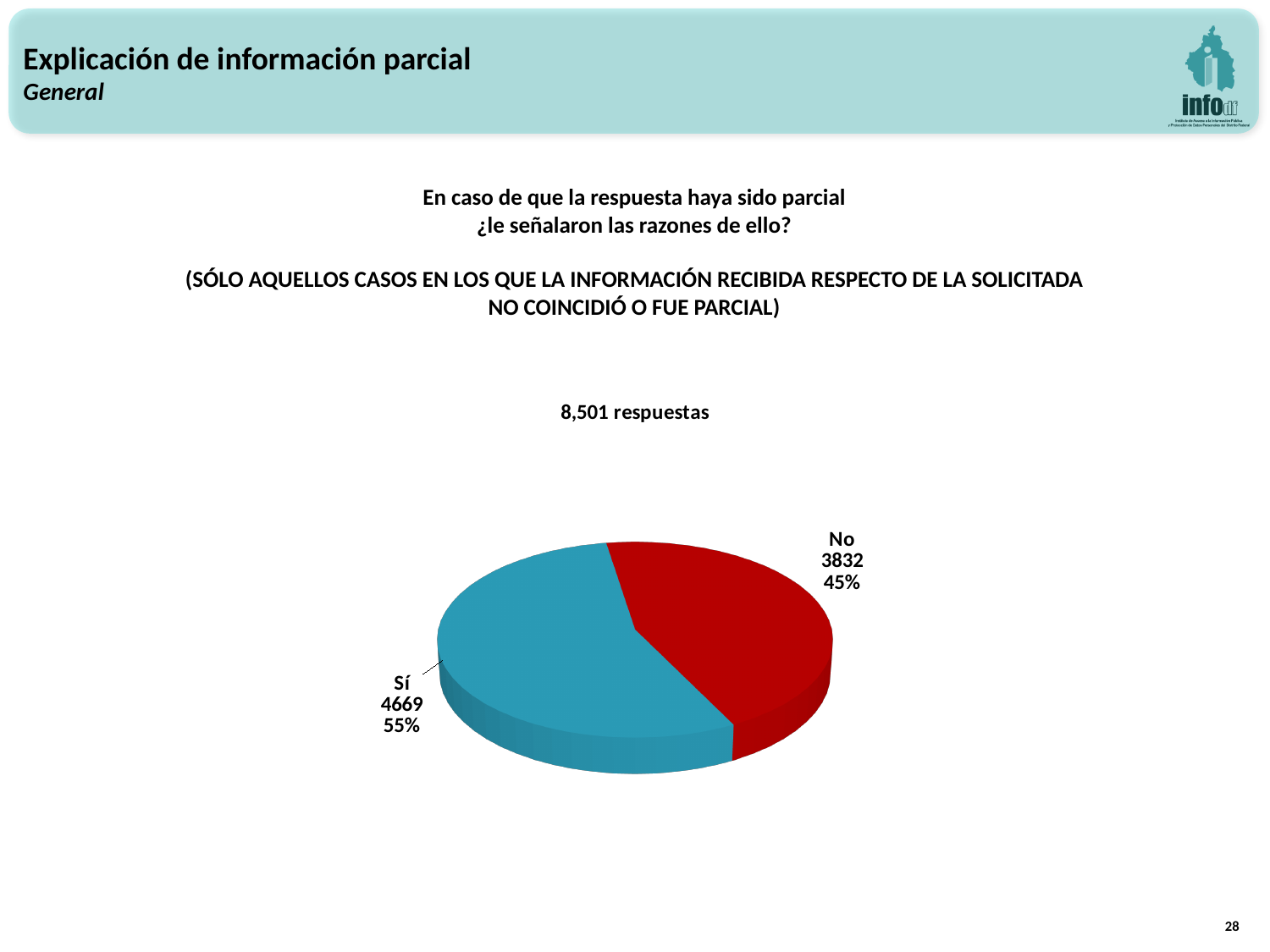
What is the difference between the "Sí" and "No" values? 837 Which slice is the smallest? No Which is larger, the value for "Sí" or the value for "No"? Sí Which slice is the largest? Sí What is the value for the "No" slice? 3832 What percentage share does the "Sí" slice represent? 55% How many total responses does the slide state the chart is based on? 8,501 respuestas What is the value for the "Sí" slice? 4669 What type of chart is shown on the slide? pie chart What percentage share does the "No" slice represent? 45% What colour is the "No" slice? red How many slices does the pie chart have? 2